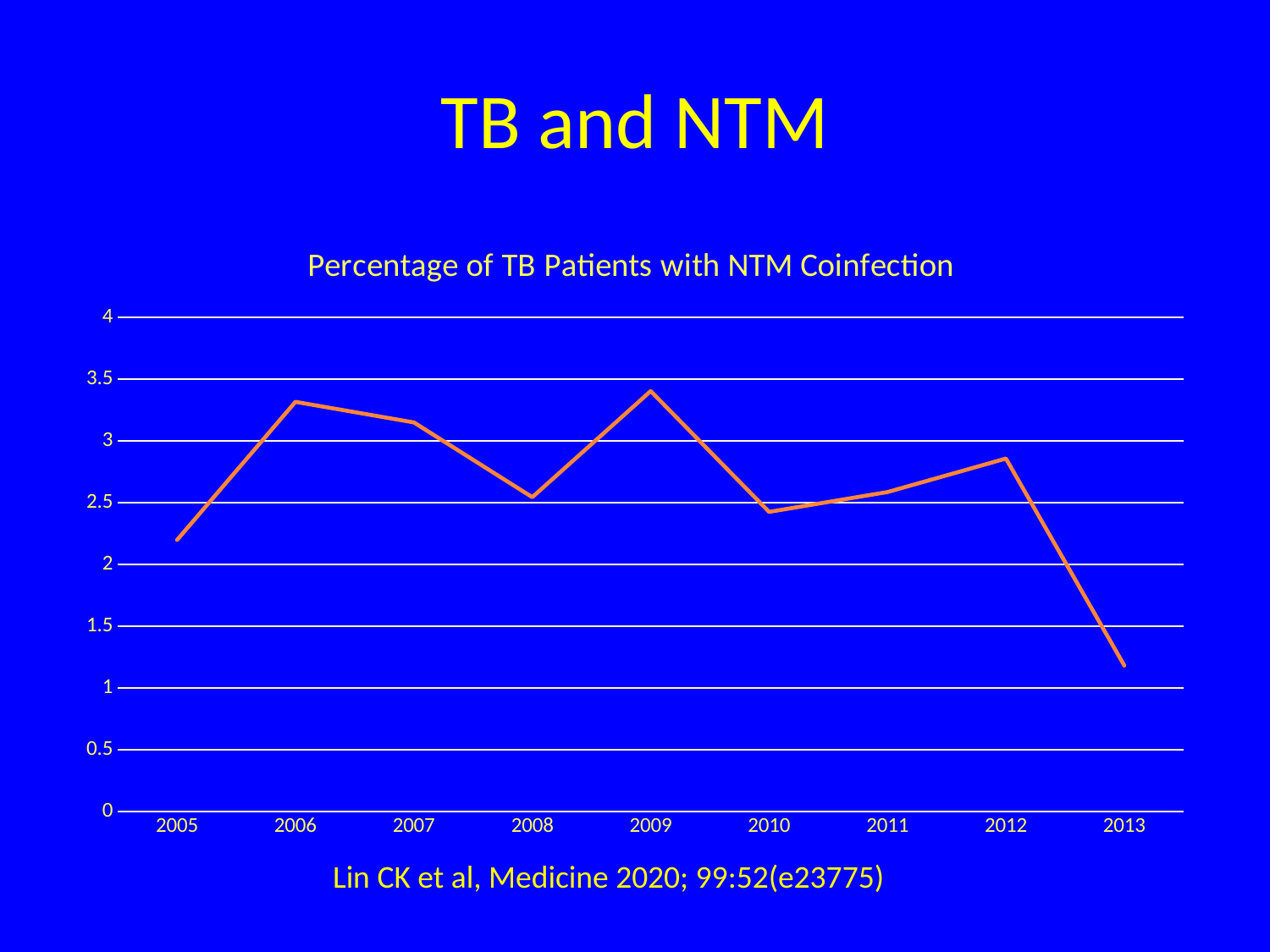
Which year has the larger value, 2008 or 2009? 2009 How many years are plotted on the x axis of the chart? 9 Does the percentage rise or fall from 2012 to 2013? fall What kind of chart is shown on the slide? line chart Is the value for 2008 greater or less than 3? less Is the value for 2013 greater or less than 1.5? less Which year has the lowest percentage of TB patients with NTM coinfection? 2013 Which year has the highest percentage of TB patients with NTM coinfection? 2009 Which year has the larger value, 2005 or 2012? 2012 Is the value for 2005 greater or less than 2.5? less What is the title of the chart? Percentage of TB Patients with NTM Coinfection